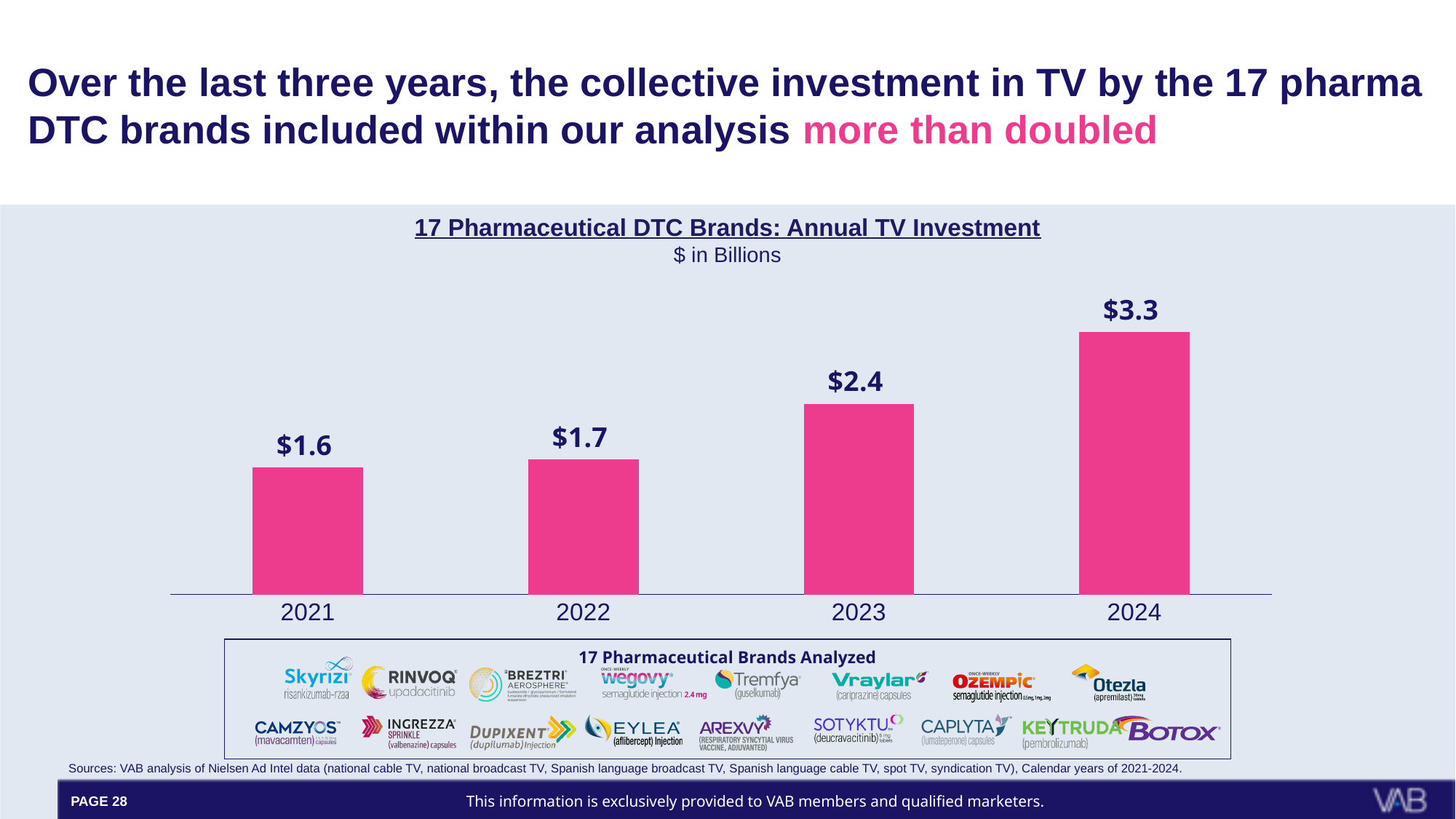
What was the annual TV investment in 2024? $3.3 What is the difference in TV investment between 2024 and 2021? $1.7 In what unit are the chart values expressed? $ in Billions What was the annual TV investment in 2023? $2.4 What was the annual TV investment in 2021? $1.6 What type of chart is shown on the slide? Bar chart Which year had the lowest annual TV investment? 2021 What is the difference in TV investment between 2023 and 2022? $0.7 Which year had a larger TV investment, 2022 or 2023? 2023 Which year had the highest annual TV investment? 2024 How many years are shown in the chart? 4 Do the TV investment values rise or fall from 2021 to 2024? Rise